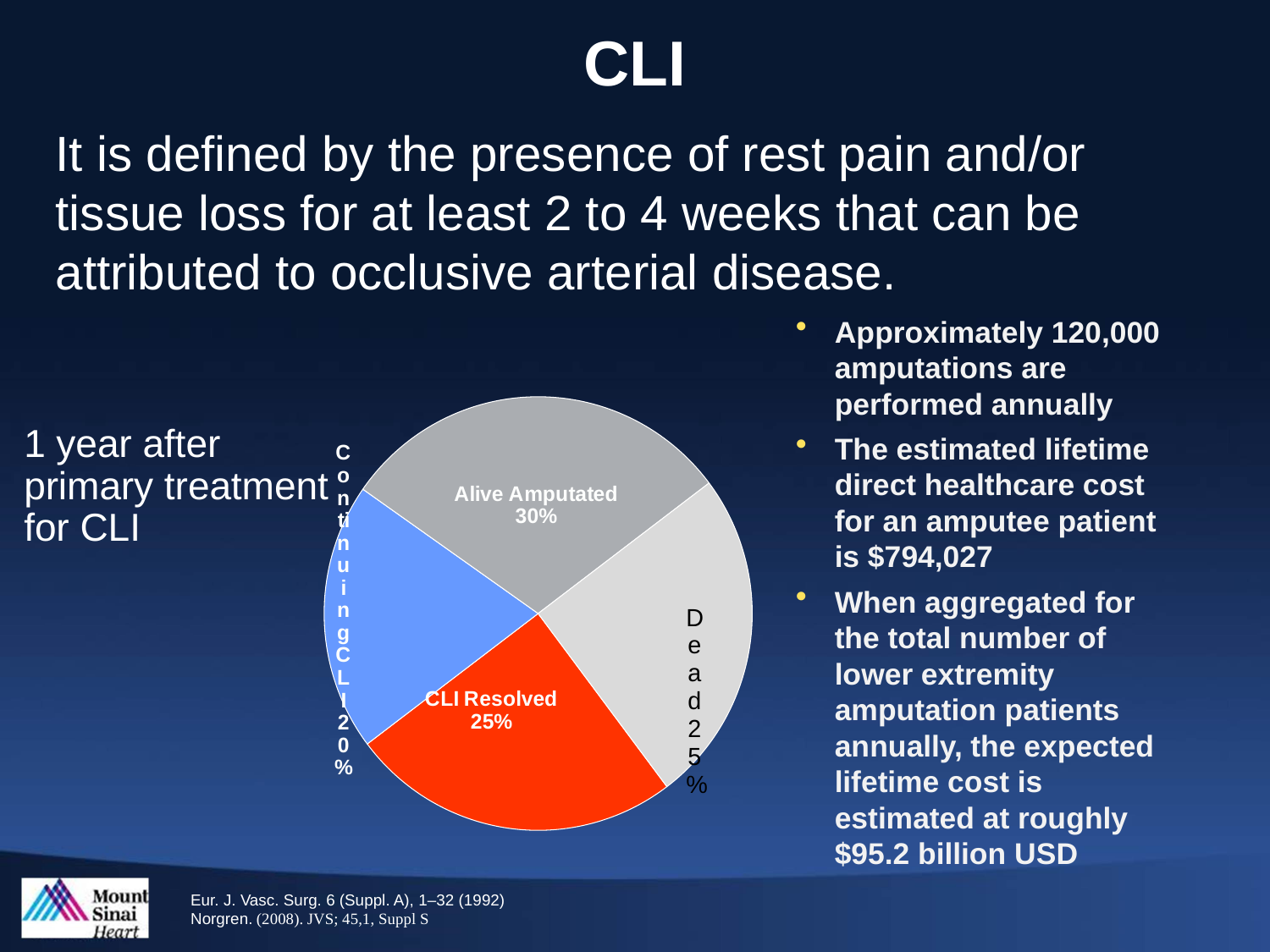
What colour is the CLI Resolved slice in the pie chart? red Which slice of the pie chart is the largest? Alive Amputated What percentage of patients have CLI Resolved according to the pie chart? 25% What type of chart is shown on the slide? pie chart What percentage of patients are Dead according to the pie chart? 25% How many slices does the pie chart have? 4 Which is larger in the pie chart, Alive Amputated or CLI Resolved? Alive Amputated What percentage of patients have Continuing CLI according to the pie chart? 20% What colour is the Continuing CLI slice in the pie chart? blue What percentage of patients are Alive Amputated 1 year after primary treatment for CLI? 30% What is the difference in percentage points between the Alive Amputated slice and the Continuing CLI slice? 10 Which slice of the pie chart is the smallest? Continuing CLI